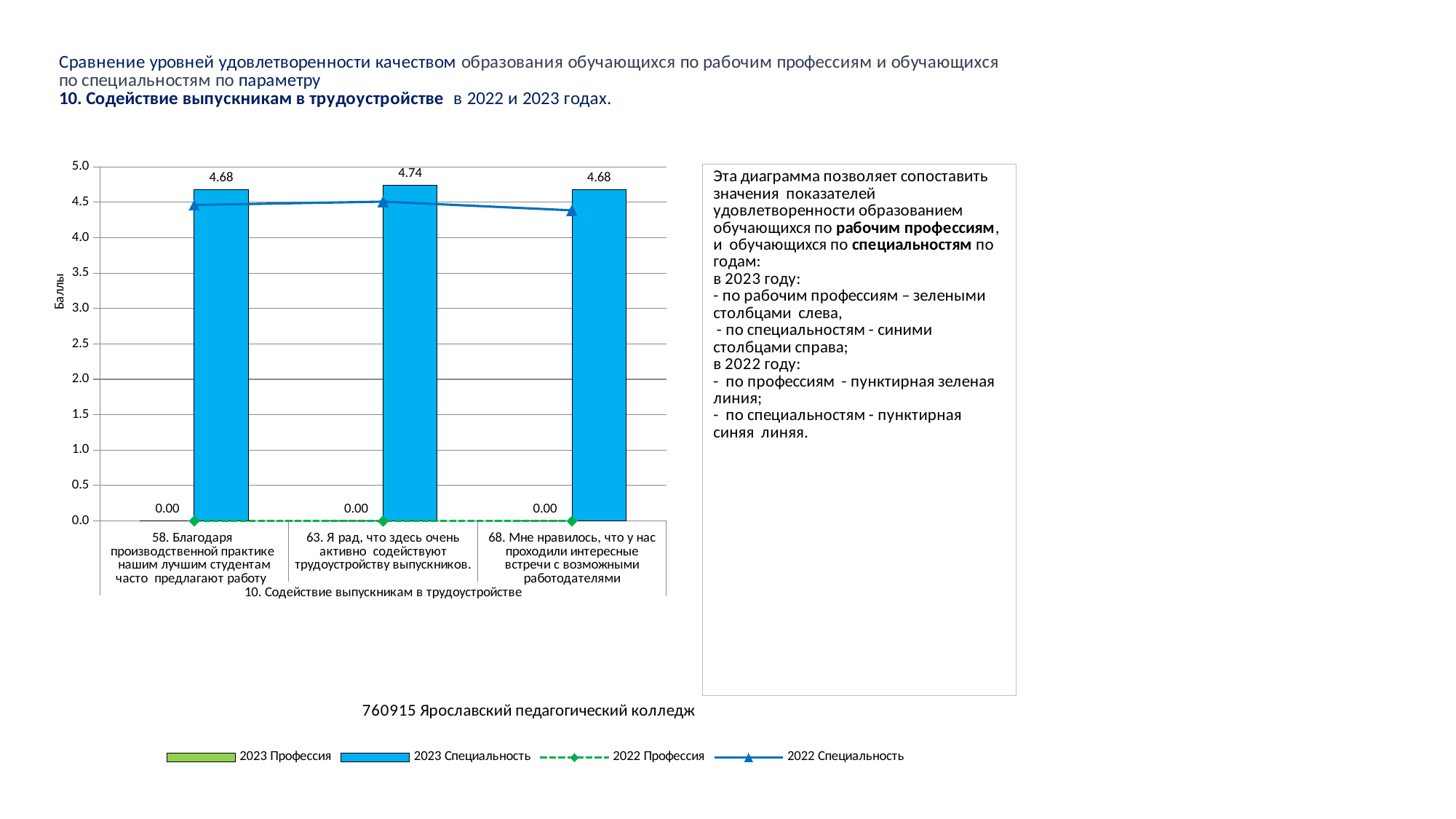
What kind of chart is shown on the slide? Bar chart combined with line series Is the 2022 Специальность value for category 68 greater or less than 4.5? less How many series does the chart legend list? 4 What is the title of the vertical axis of the chart? Баллы What is the value of the 2023 Специальность bar for category 63 (Я рад, что здесь очень активно содействуют трудоустройству выпускников)? 4.74 Is the 2022 Специальность value for category 58 greater or less than 4.0? greater How many categories are shown on the x axis of the chart? 3 Which is larger: the 2023 Специальность value for category 63 or for category 68? Category 63 What is the value of the 2023 Специальность bar for category 58 (Благодаря производственной практике нашим лучшим студентам часто предлагают работу)? 4.68 Which category has the highest 2023 Специальность value? 63. Я рад, что здесь очень активно содействуют трудоустройству выпускников. What value is shown for 2023 Профессия for category 68 (Мне нравилось, что у нас проходили интересные встречи с возможными работодателями)? 0.00 What is the difference between the 2023 Специальность values for category 63 and category 68? 0.06